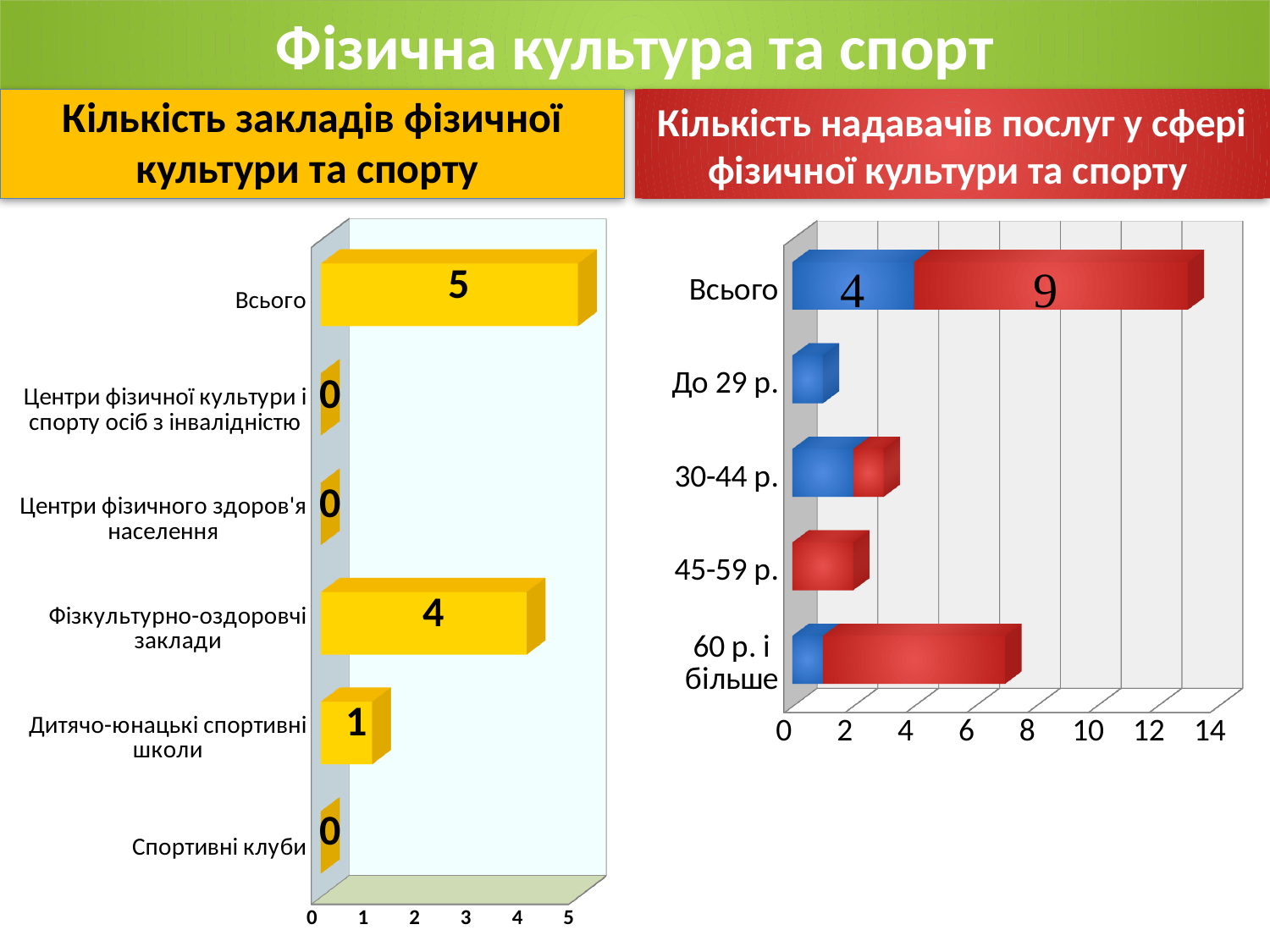
In the chart 'Кількість надавачів послуг у сфері фізичної культури та спорту', what is the total of the stacked bar for 'Всього'? 13 In the chart 'Кількість закладів фізичної культури та спорту', how many categories are shown? 6 In the chart 'Кількість закладів фізичної культури та спорту', what is the value for 'Фізкультурно-оздоровчі заклади'? 4 In the chart 'Кількість закладів фізичної культури та спорту', what is the value for 'Дитячо-юнацькі спортивні школи'? 1 What kind of chart is 'Кількість закладів фізичної культури та спорту'? Bar chart In the chart 'Кількість закладів фізичної культури та спорту', which category has the highest value? Всього In the chart 'Кількість закладів фізичної культури та спорту', what is the value for 'Всього'? 5 In the chart 'Кількість закладів фізичної культури та спорту', what is the difference between 'Всього' and 'Фізкультурно-оздоровчі заклади'? 1 In the chart 'Кількість закладів фізичної культури та спорту', what is the value for 'Спортивні клуби'? 0 In the chart 'Кількість надавачів послуг у сфері фізичної культури та спорту', what is the value of the red segment for 'Всього'? 9 In the chart 'Кількість надавачів послуг у сфері фізичної культури та спорту', is the total value for '60 р. і більше' greater or less than 4? greater In the chart 'Кількість надавачів послуг у сфері фізичної культури та спорту', how many categories are shown on the vertical axis? 5